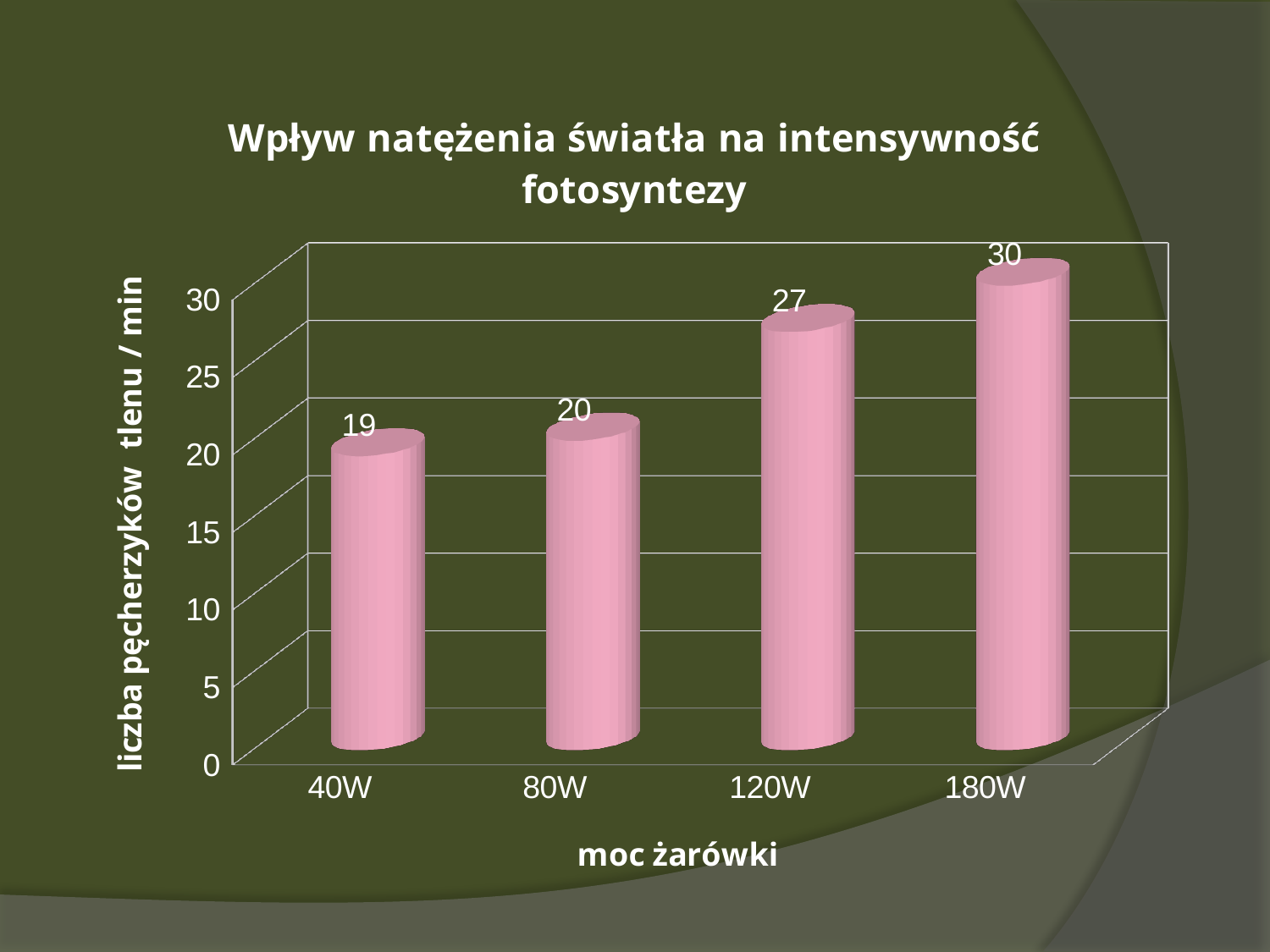
Which is larger, the value for 80W or the value for 120W? 120W What is the difference between the values for 120W and 80W? 7 What is the title of the chart? Wpływ natężenia światła na intensywność fotosyntezy What is the value for 40W? 19 Which category has the lowest value? 40W What is the value for 180W? 30 Which category has the highest value? 180W How many categories are shown on the x axis? 4 What is the value for 120W? 27 What is the difference between the values for 180W and 40W? 11 What kind of chart is this? bar chart Do the values rise or fall from 40W to 180W? rise